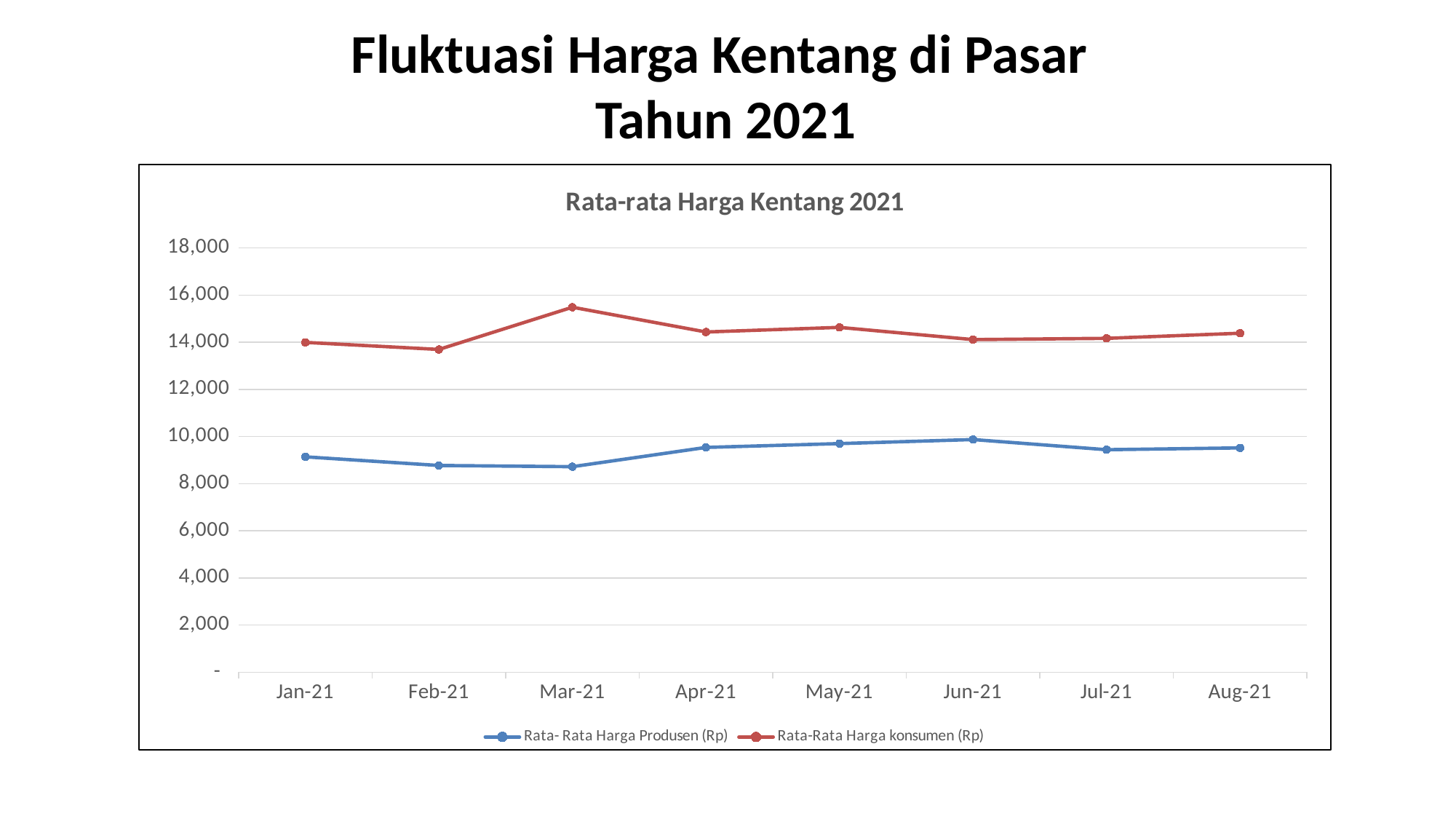
How many months are plotted along the x axis? 8 Is the Rata-Rata Harga konsumen (Rp) value for Mar-21 greater or less than 14,000? greater Is the Rata- Rata Harga Produsen (Rp) value for Mar-21 greater or less than 8,000? greater In which month is the Rata-Rata Harga konsumen (Rp) value highest? Mar-21 Is the Rata- Rata Harga Produsen (Rp) value for Jun-21 greater or less than 10,000? less Does the Rata- Rata Harga Produsen (Rp) line rise or fall from Mar-21 to Jun-21? rise How many series does the legend list? 2 What is the title printed inside the chart area? Rata-rata Harga Kentang 2021 In which month is the Rata-Rata Harga konsumen (Rp) value lowest? Feb-21 In which month is the Rata- Rata Harga Produsen (Rp) value highest? Jun-21 What kind of chart is shown on the slide? line chart In Mar-21, which series has the larger value: Rata- Rata Harga Produsen (Rp) or Rata-Rata Harga konsumen (Rp)? Rata-Rata Harga konsumen (Rp)